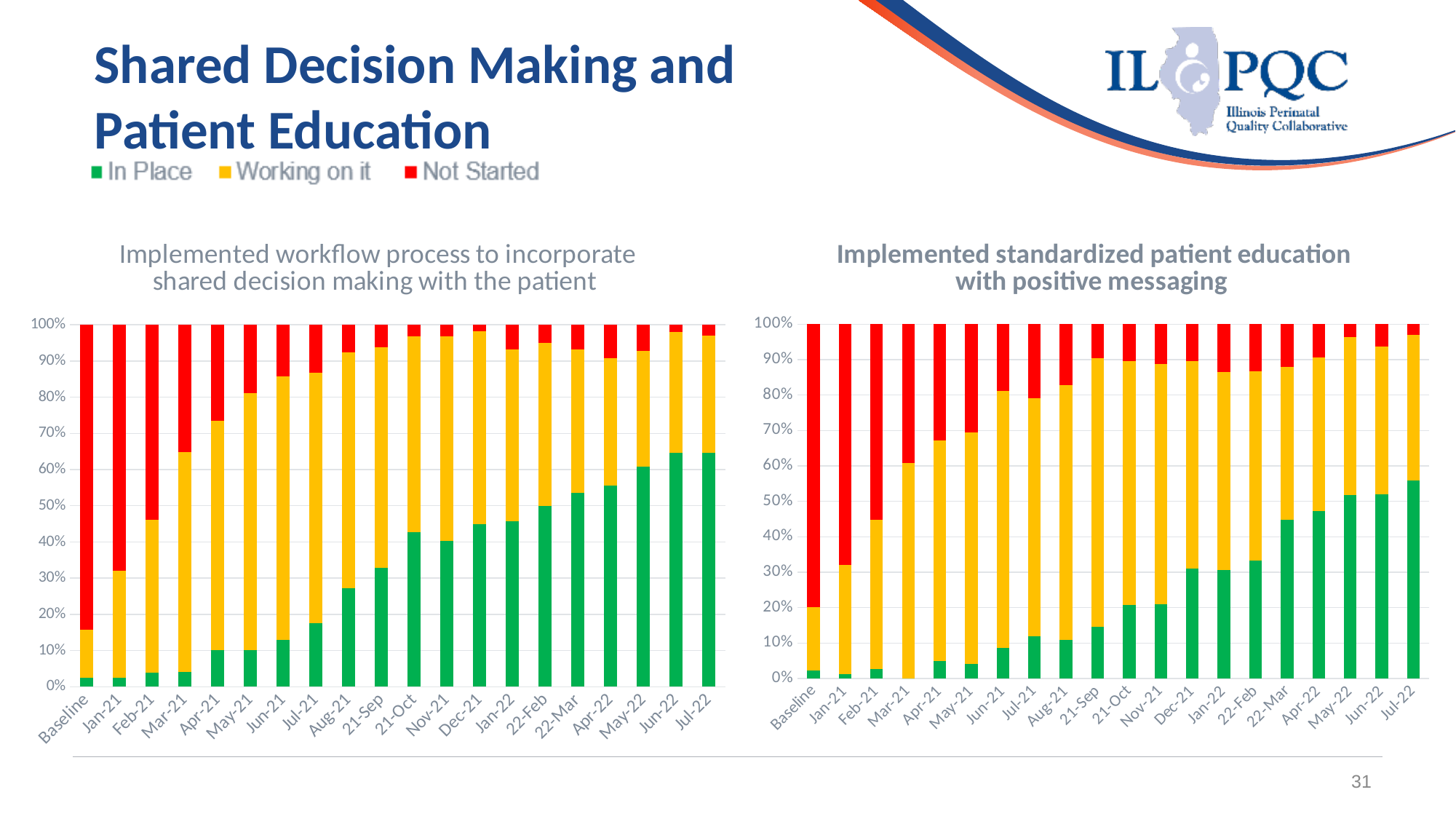
In the left chart, is the 'In Place' value at Baseline greater or less than 10%? less How many time-period categories are shown on the x axis of the right chart, 'Implemented standardized patient education with positive messaging'? 20 In the left chart, is the 'In Place' value for Jul-22 greater or less than 60%? greater In the left chart, which is larger: the 'In Place' value for Apr-22 or for Dec-21? Apr-22 In the right chart, which category has the largest 'Not Started' share? Baseline In the right chart, is the 'In Place' value for Jul-22 greater or less than 50%? greater In the left chart, does the 'In Place' share generally rise or fall from Baseline to Jul-22? Rise In the right chart, which category has the highest 'In Place' value? Jul-22 How many series does the legend at the top of the slide list? 3 What kind of chart is the left chart, 'Implemented workflow process to incorporate shared decision making with the patient'? Stacked bar chart